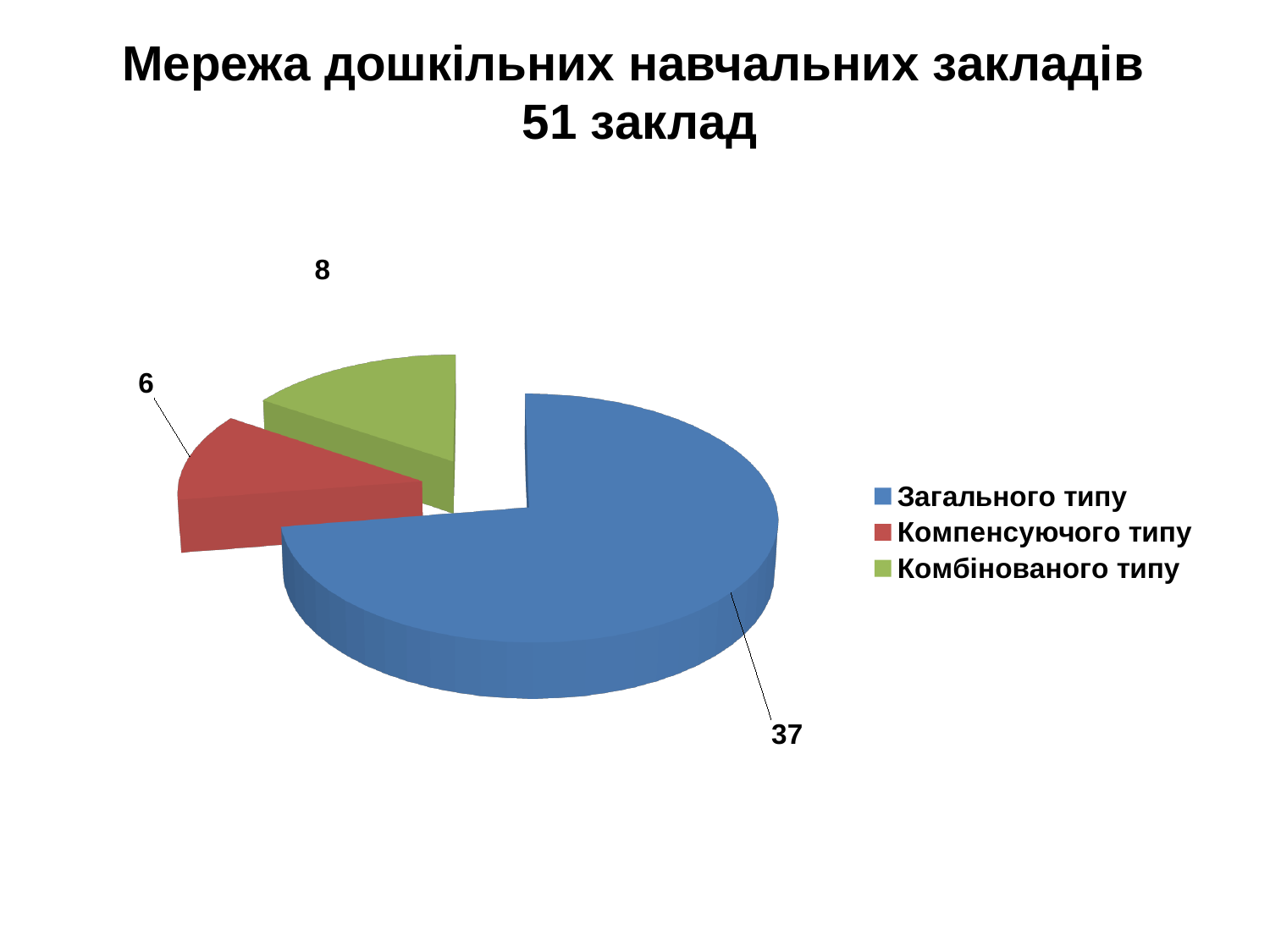
What is the value for Комбінованого типу? 8 What is the value for Загального типу? 37 Which is larger, the value for Комбінованого типу or the value for Компенсуючого типу? Комбінованого типу How many categories does the pie chart have? 3 What colour is the slice for Загального типу? blue Which category has the smallest slice of the pie? Компенсуючого типу What is the difference between the values for Комбінованого типу and Компенсуючого типу? 2 What is the value for Компенсуючого типу? 6 What is the total of all slices in the pie chart? 51 Which category has the largest slice of the pie? Загального типу What type of chart is shown on the slide? pie chart What is the difference between the values for Загального типу and Комбінованого типу? 29